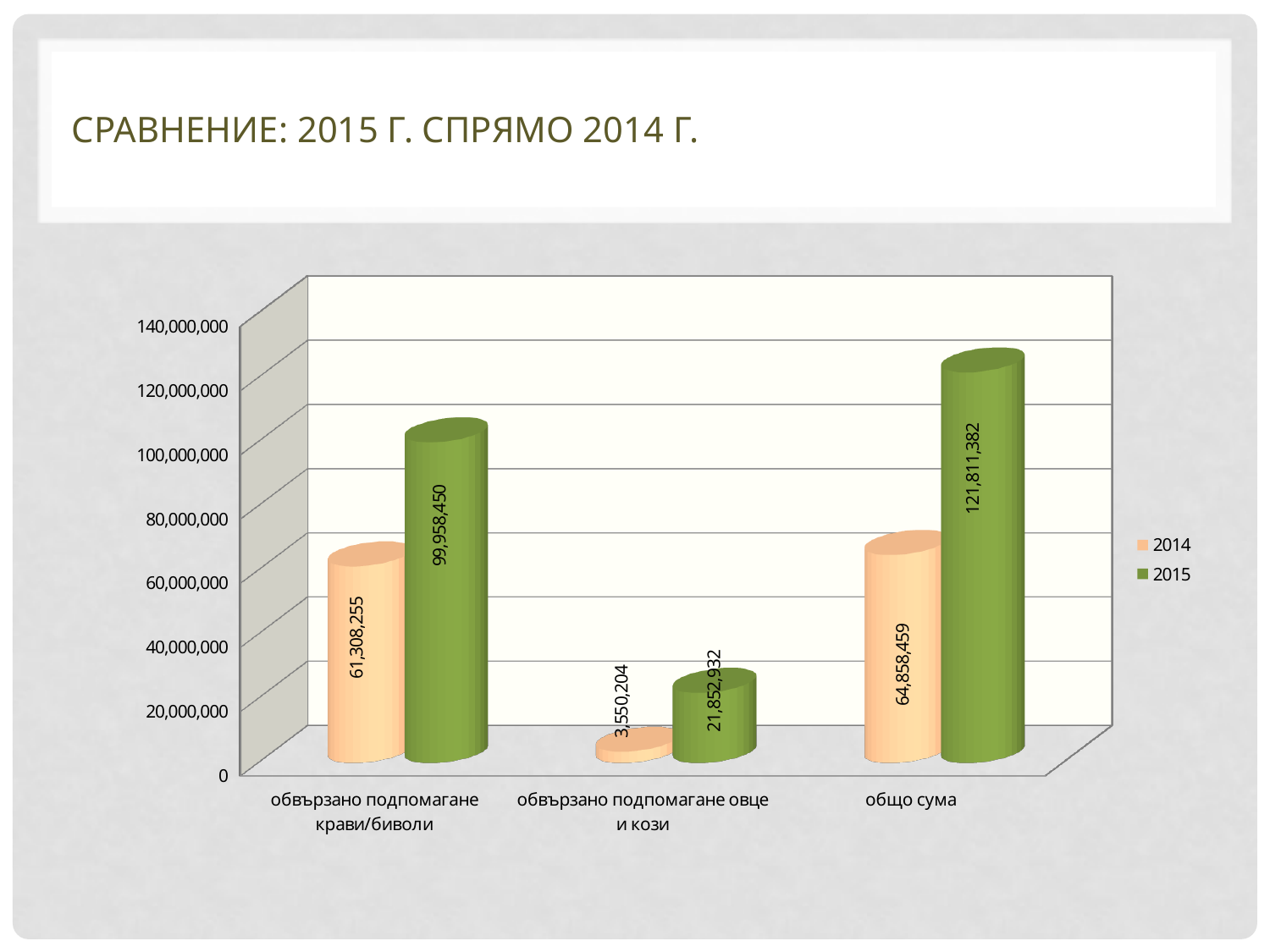
What is the 2014 value for обвързано подпомагане овце и кози? 3,550,204 What is the 2015 value for обвързано подпомагане овце и кози? 21,852,932 Which is larger for обвързано подпомагане овце и кози: the 2014 value or the 2015 value? 2015 What is the 2014 value for обвързано подпомагане крави/биволи? 61,308,255 How many series does the legend list? 2 How many categories are shown on the x axis? 3 What is the difference between the 2015 and 2014 values for обвързано подпомагане крави/биволи? 38,650,195 What kind of chart is shown on the slide? bar chart Which category has the lowest 2014 value? обвързано подпомагане овце и кози Which category has the highest 2015 value? общо сума What is the 2015 value for общо сума? 121,811,382 What is the difference between the 2015 and 2014 values for общо сума? 56,952,923